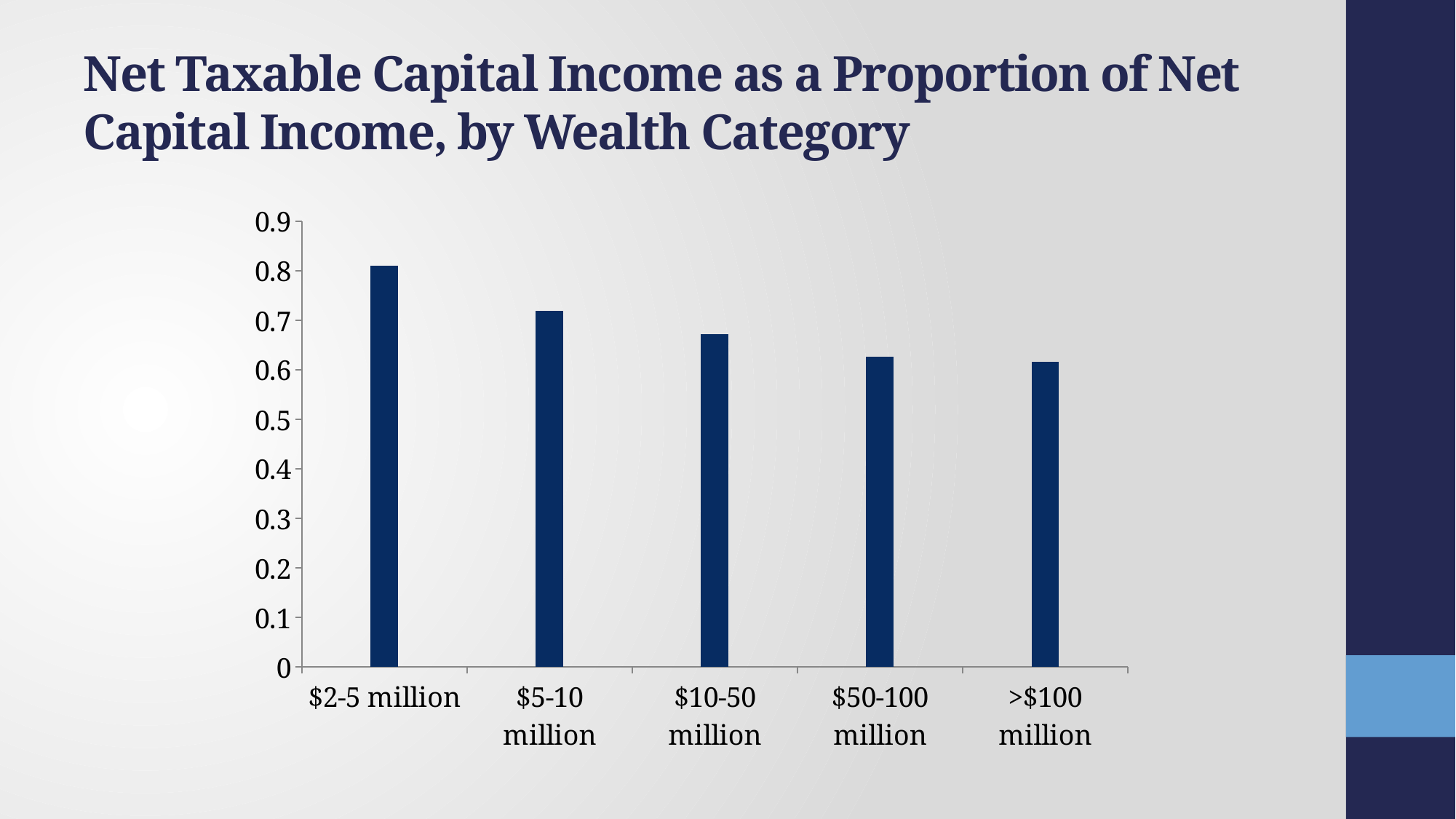
Which wealth category has the highest proportion of net taxable capital income? $2-5 million Is the value for $5-10 million greater or less than 0.7? greater Which is larger, the value for $5-10 million or the value for $10-50 million? $5-10 million Is the value for $2-5 million greater or less than 0.7? greater Which is larger, the value for $2-5 million or the value for $5-10 million? $2-5 million Is the value for >$100 million greater or less than 0.7? less What is the title of the chart on the slide? Net Taxable Capital Income as a Proportion of Net Capital Income, by Wealth Category Do the values rise or fall as you move from the $2-5 million category to the >$100 million category? fall What kind of chart is shown on the slide? bar chart How many wealth categories are plotted on the chart? 5